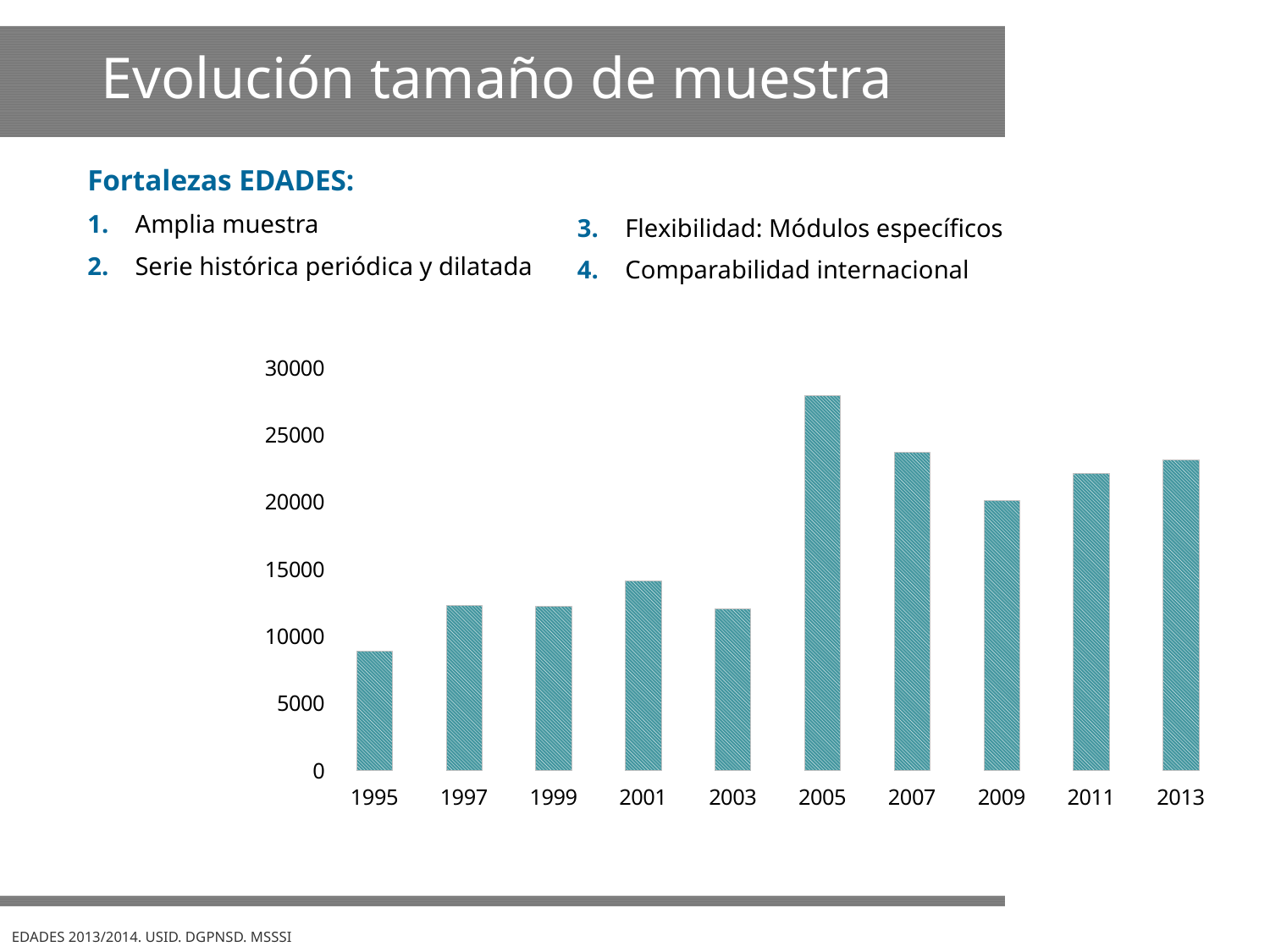
Is the value for 2005 greater or less than 25000? greater Do the values rise or fall from 2009 to 2013? rise Which is larger, the value for 1995 or the value for 2001? 2001 What kind of chart is shown on the slide? bar chart Is the value for 1995 greater or less than 10000? less What is the highest value shown on the y axis of the chart? 30000 Which year has the highest bar in the chart? 2005 Which year has the lowest bar in the chart? 1995 Is the value for 2003 greater or less than 15000? less How many years are shown on the x axis of the chart? 10 Which is larger, the value for 2005 or the value for 2007? 2005